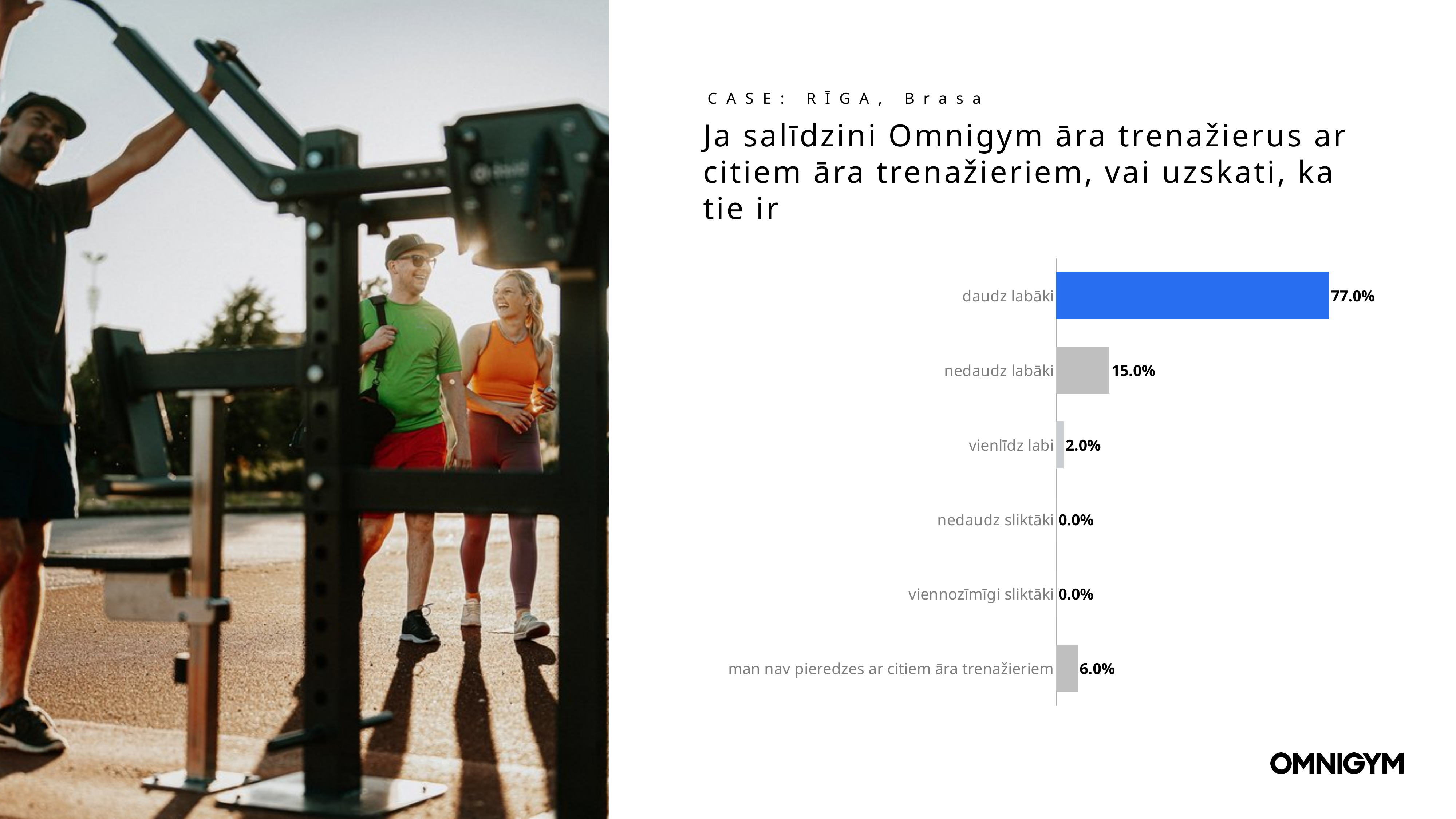
Which category has the highest value? daudz labāki What is the value for "man nav pieredzes ar citiem āra trenažieriem"? 6.0% How many categories have a value of 0.0%? 2 What kind of chart is shown on the slide? bar chart What is the value for "nedaudz sliktāki"? 0.0% What is the value for "nedaudz labāki"? 15.0% How many categories does the chart show? 6 What is the value for "vienlīdz labi"? 2.0% What is the difference between the values for "daudz labāki" and "nedaudz labāki"? 62.0% Which bar is coloured blue rather than grey? daudz labāki What is the value for "daudz labāki"? 77.0% Which is larger, the value for "man nav pieredzes ar citiem āra trenažieriem" or the value for "vienlīdz labi"? man nav pieredzes ar citiem āra trenažieriem